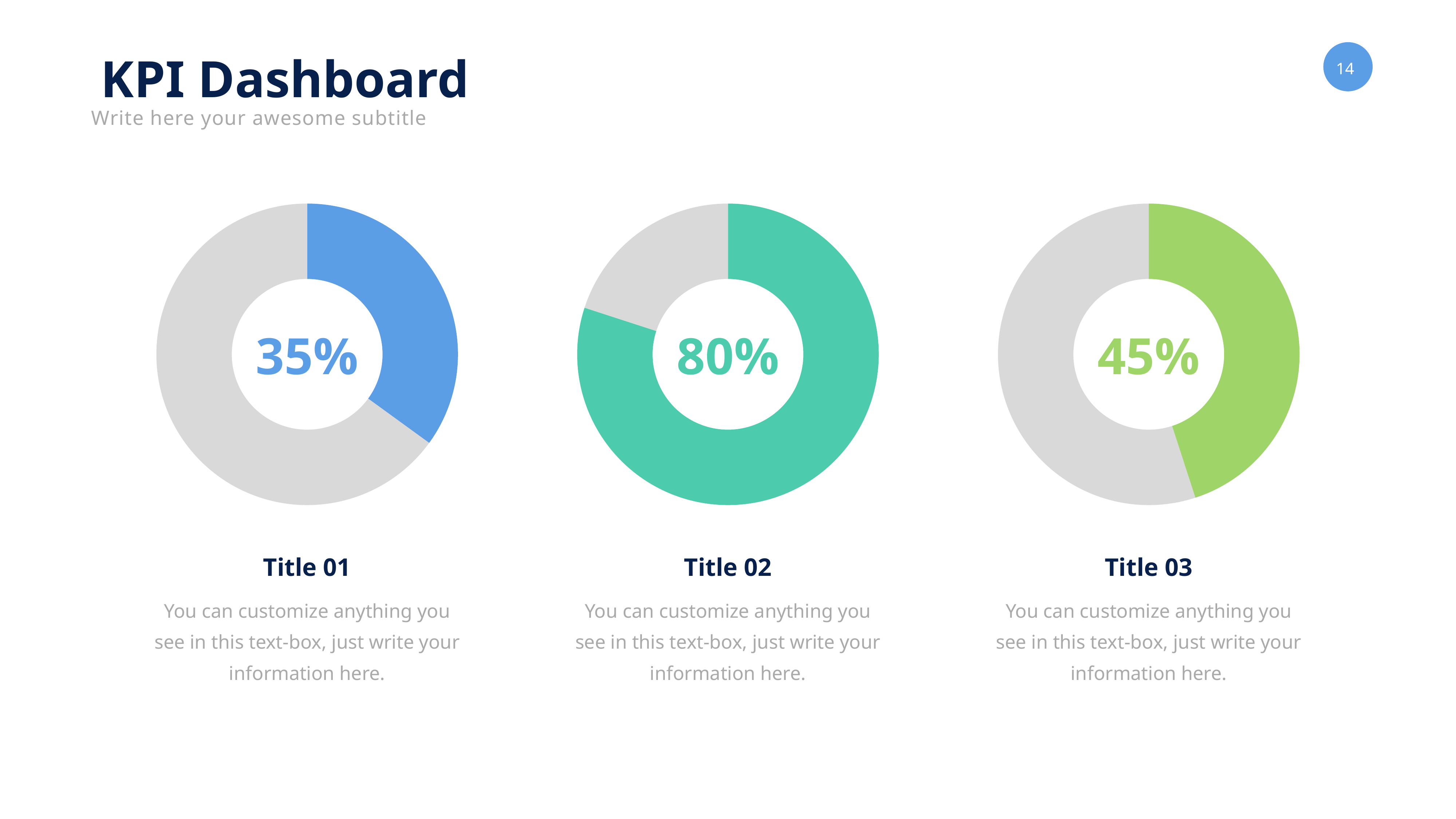
What kind of chart is used for Title 01, Title 02 and Title 03? Donut chart What is the title of the slide containing the three donut charts? KPI Dashboard What percentage is shown in the centre of the Title 03 donut chart? 45% What percentage is shown in the centre of the Title 01 donut chart? 35% What percentage is shown in the centre of the Title 02 donut chart? 80% What colour is the filled portion of the Title 02 donut chart? Teal/green What is the difference between the percentage in the Title 02 chart and the percentage in the Title 01 chart? 45% Which is larger, the percentage in the Title 03 chart or the percentage in the Title 01 chart? Title 03 How many donut charts are shown on the slide? 3 Which of the three donut charts (Title 01, Title 02, Title 03) shows the lowest percentage? Title 01 Which of the three donut charts (Title 01, Title 02, Title 03) shows the highest percentage? Title 02 What is the difference between the percentage in the Title 03 chart and the percentage in the Title 01 chart? 10%